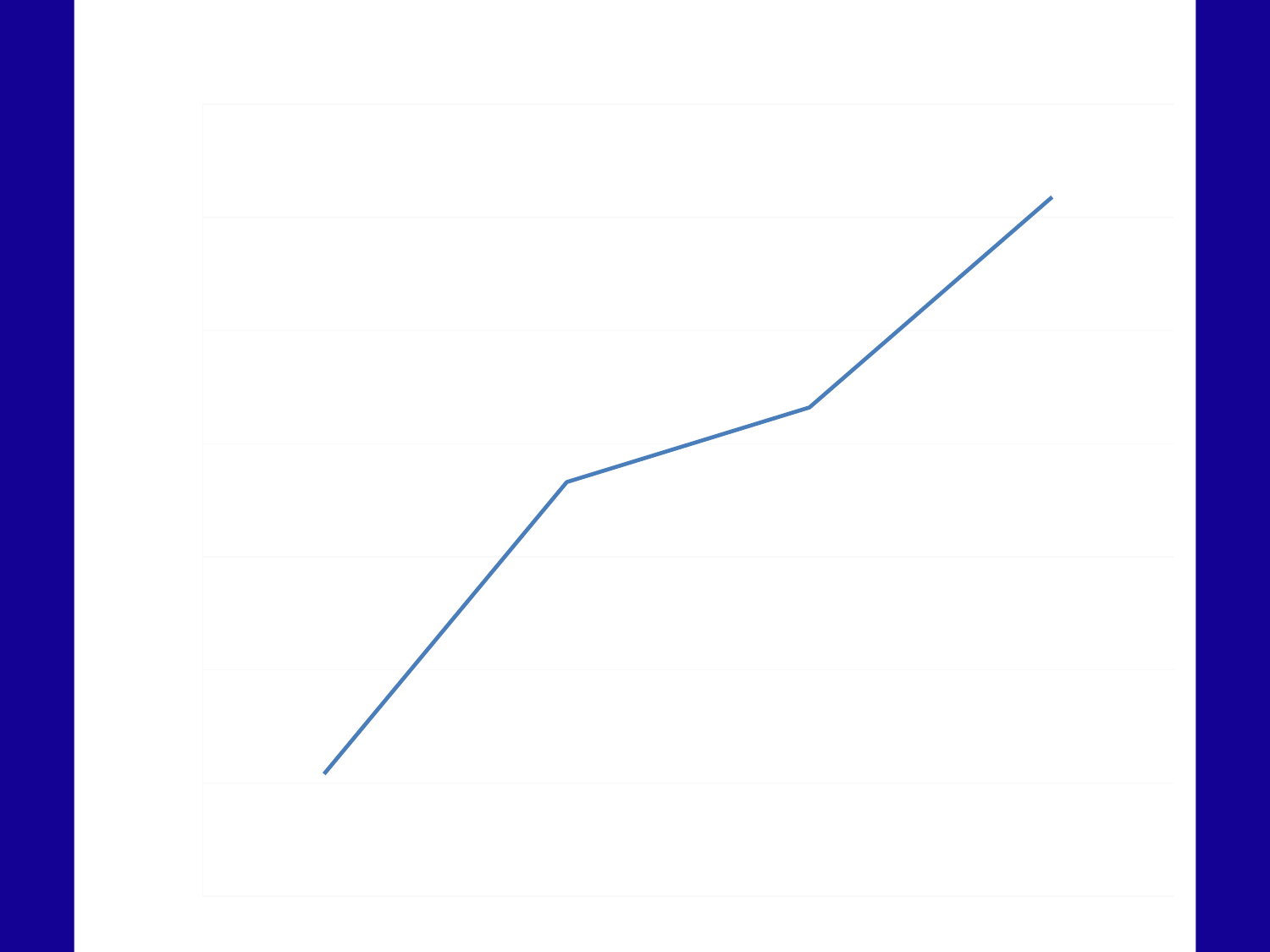
How many data points does the line on the chart have? 4 What colour is the line on the chart? blue What kind of chart is shown on the slide? line chart How many lines are plotted on the chart? 1 Do the values on the line chart rise or fall from left to right? rise